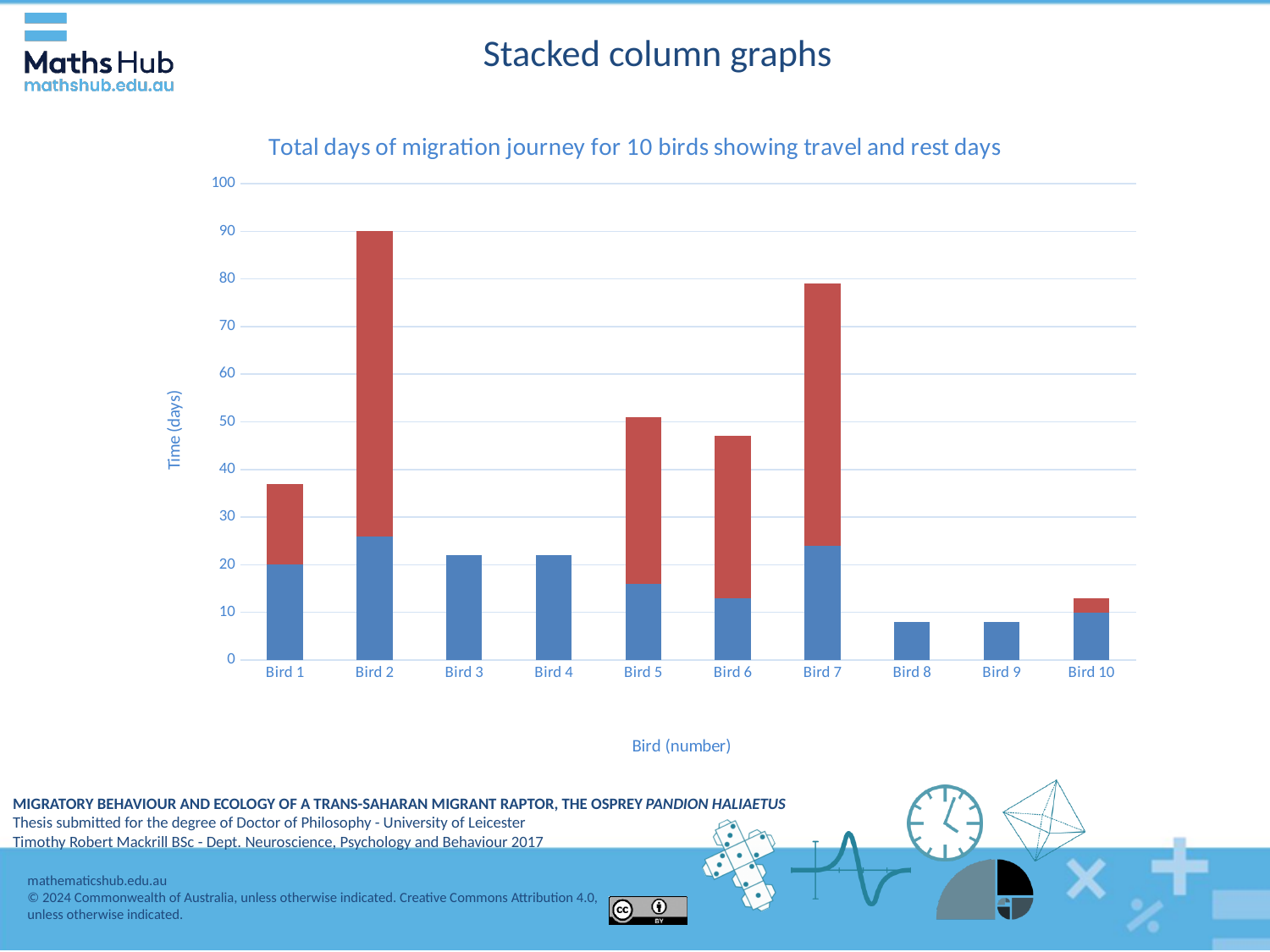
What is the value of the blue (bottom) segment for Bird 1? 20 What kind of chart is shown on the slide? Stacked bar chart What is the title of the chart? Total days of migration journey for 10 birds showing travel and rest days Is the total value for Bird 7 greater or less than 70? greater How many birds are shown along the x axis of the chart? 10 Which has a larger total, Bird 7 or Bird 5? Bird 7 What is the label on the y axis of the chart? Time (days) Which bird has the highest total number of days? Bird 2 What is the value of the blue (bottom) segment for Bird 10? 10 What is the total number of days for Bird 2? 90 Is the total value for Bird 6 greater or less than 50? less Is the total value for Bird 8 greater or less than 10? less